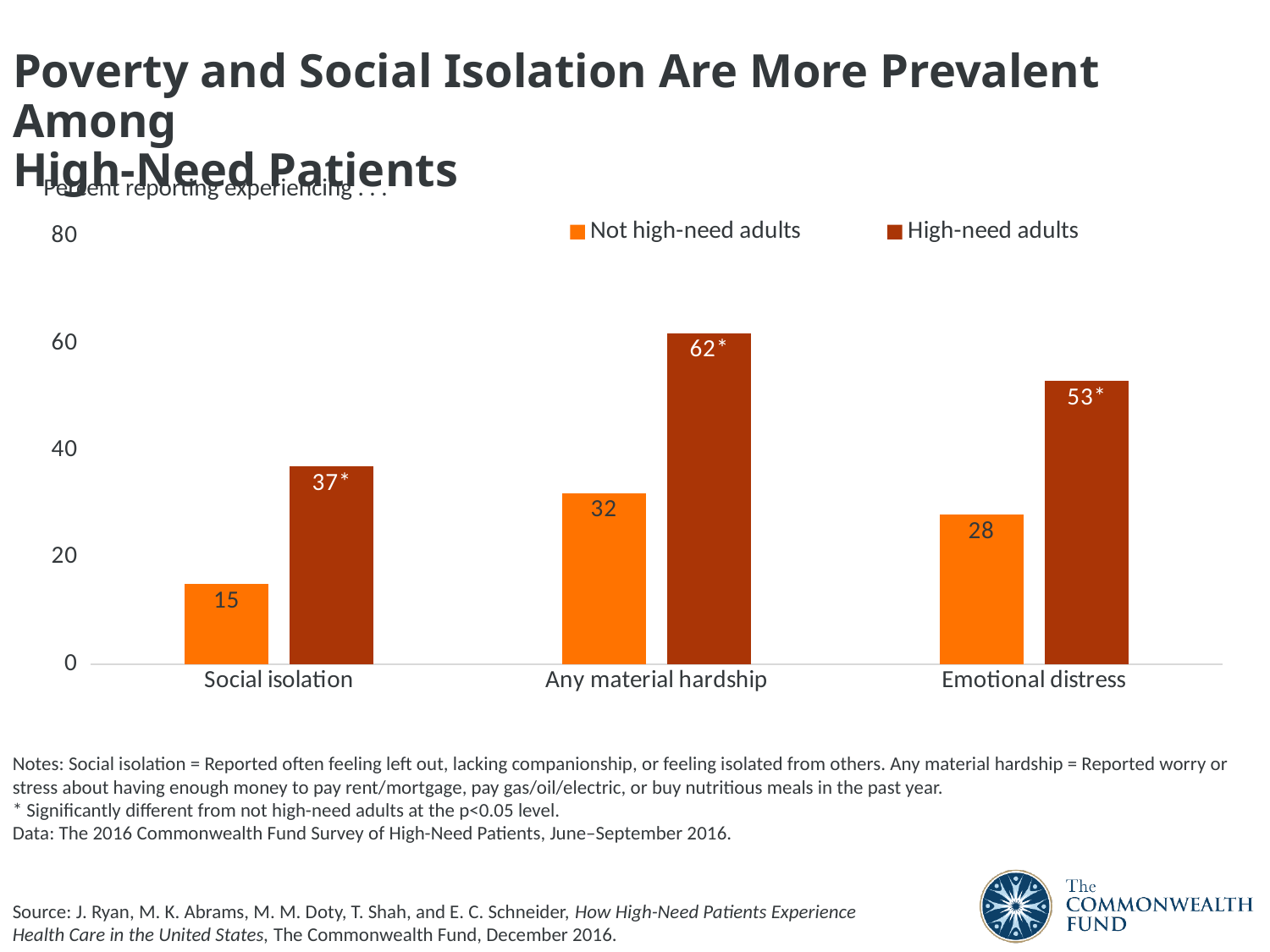
How many series does the legend list? 2 What percentage of high-need adults reported any material hardship? 62 For any material hardship, which group has the larger value: high-need adults or not high-need adults? High-need adults How many categories are shown on the x axis? 3 What percentage of not high-need adults reported any material hardship? 32 What percentage of not high-need adults reported social isolation? 15 What percentage of high-need adults reported emotional distress? 53 What kind of chart is shown on the slide? Bar chart What is the difference between high-need adults and not high-need adults for emotional distress? 25 What is the difference between high-need adults and not high-need adults for social isolation? 22 Which category has the highest value for high-need adults? Any material hardship Which category has the lowest value for not high-need adults? Social isolation